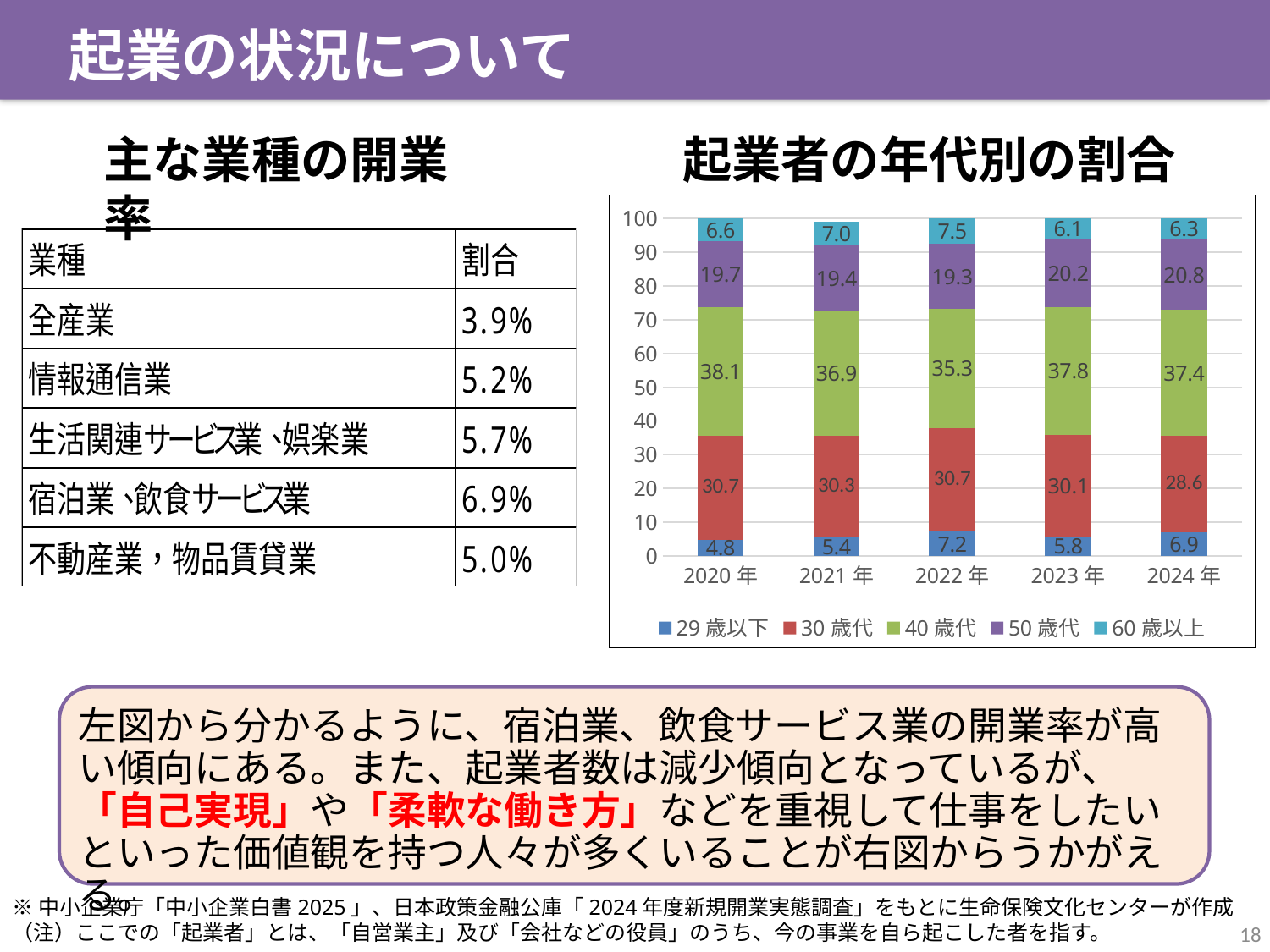
In the 起業者の年代別の割合 chart, what is the difference between the 40 歳代 values for 2020 年 and 2022 年? 2.8 In the 起業者の年代別の割合 chart, what is the value for 60 歳以上 in 2024 年? 6.3 How many years are shown on the x axis of the 起業者の年代別の割合 chart? 5 In the 起業者の年代別の割合 chart, what is the value for 40 歳代 in 2020 年? 38.1 In the 起業者の年代別の割合 chart, what is the value for 29 歳以下 in 2022 年? 7.2 In the 起業者の年代別の割合 chart, which series is shown in green? 40 歳代 In the 起業者の年代別の割合 chart, which is larger in 2023 年: 50 歳代 or 60 歳以上? 50 歳代 How many series does the legend of the 起業者の年代別の割合 chart list? 5 In the 起業者の年代別の割合 chart, which year has the lowest value for 30 歳代? 2024 年 In the 起業者の年代別の割合 chart, what is the total of the stacked bar for 2022 年? 100.0 What kind of chart is the 起業者の年代別の割合 chart? Stacked bar chart In the 起業者の年代別の割合 chart, which year has the highest value for 29 歳以下? 2022 年